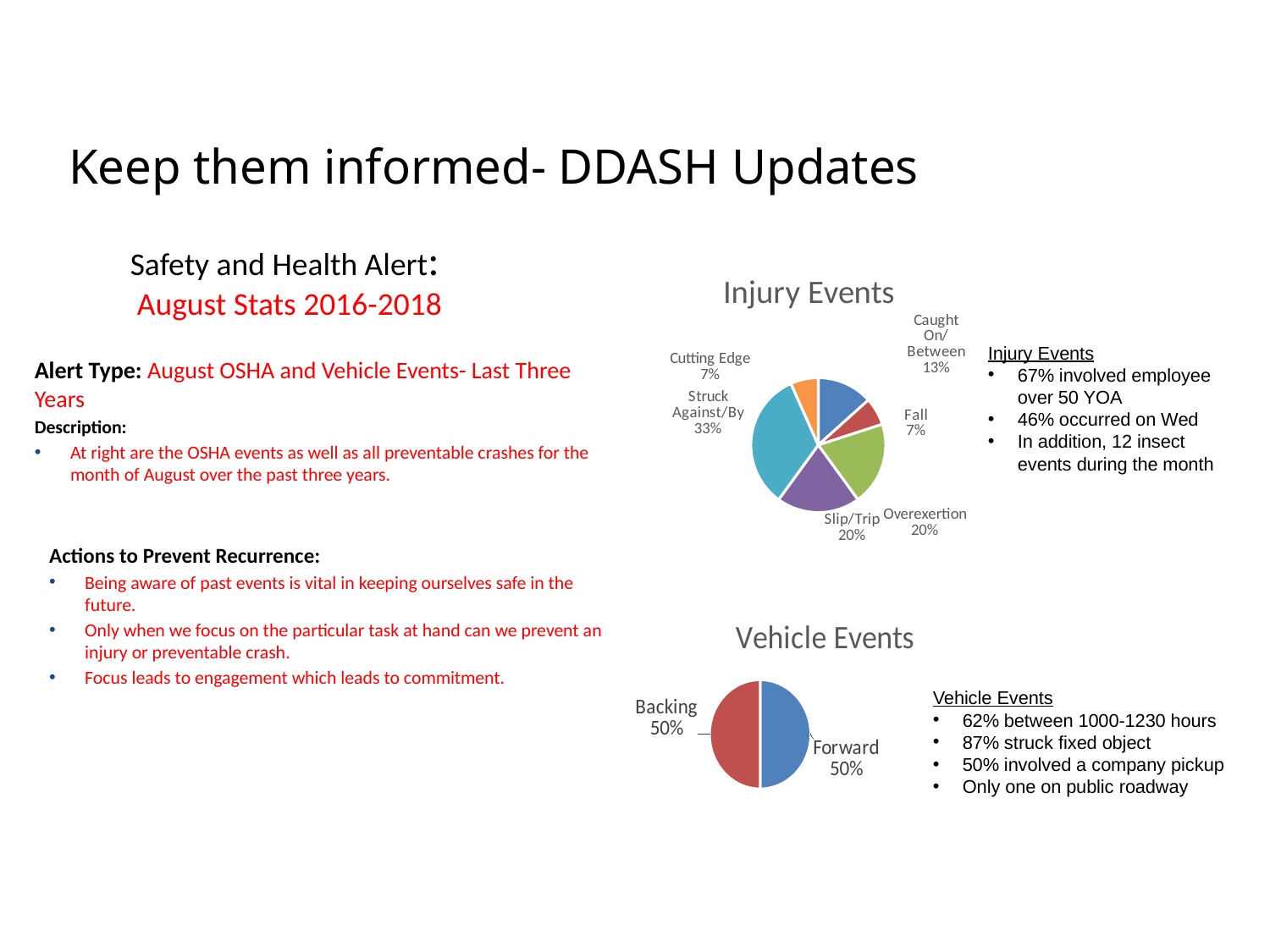
In the Injury Events chart, what is the difference in percentage points between Struck Against/By and Fall? 26 In the Vehicle Events chart, how many categories are shown? 2 In the Injury Events chart, what percentage is shown for Overexertion? 20% In the Injury Events chart, which is larger, Caught On/Between or Cutting Edge? Caught On/Between In the Injury Events chart, what share of injury events is Struck Against/By? 33% What is the title of the lower chart on the slide? Vehicle Events In the Vehicle Events chart, what percentage is shown for Forward? 50% What kind of chart is the Injury Events chart? Pie chart In the Injury Events chart, which category has the largest share? Struck Against/By In the Injury Events chart, how many categories (slices) are shown? 6 In the Vehicle Events chart, what share of vehicle events is Backing? 50% In the Injury Events chart, what percentage is shown for Caught On/Between? 13%